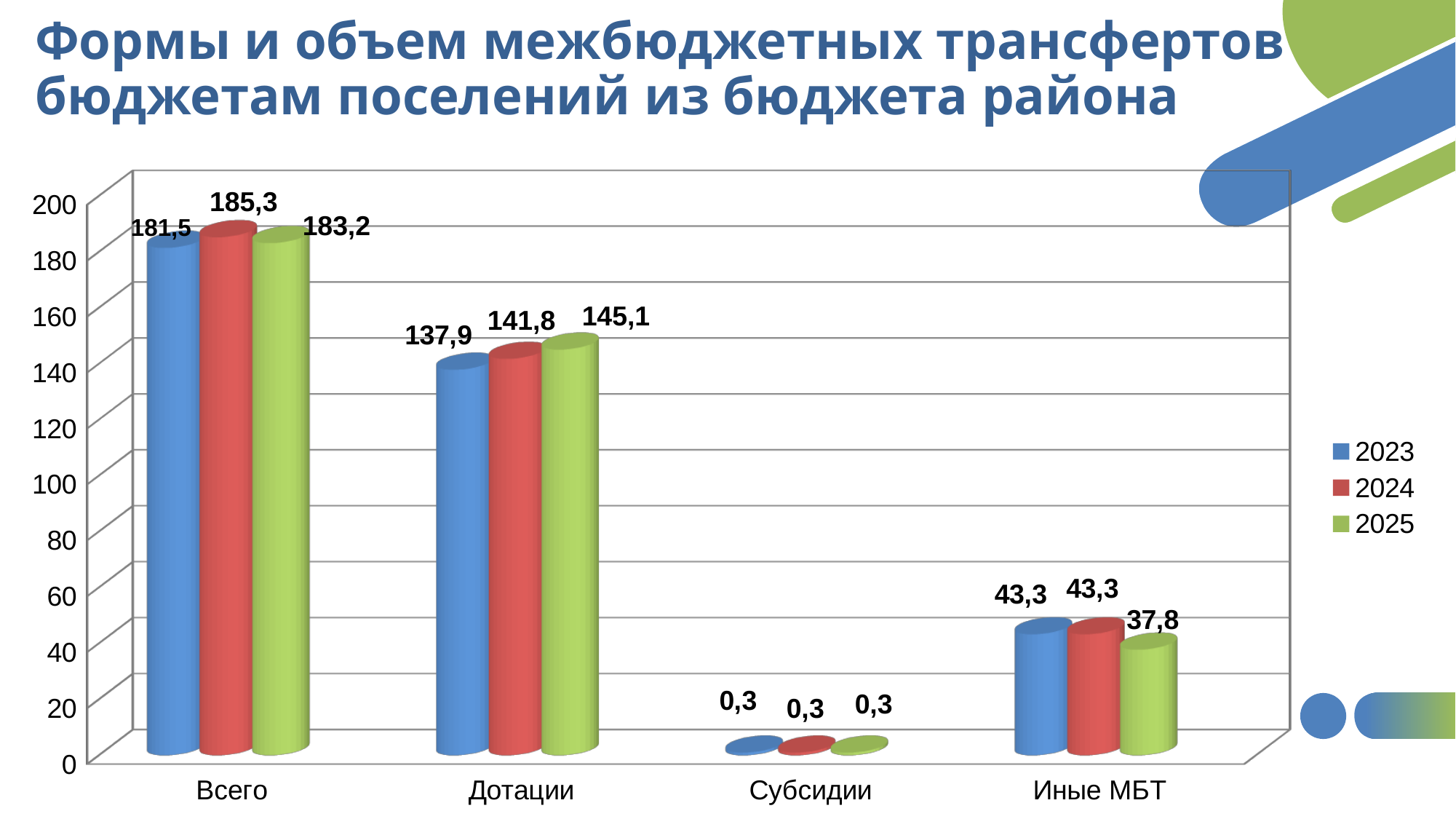
What is the value for Субсидии in 2024? 0,3 What is the value for Дотации in 2025? 145,1 What kind of chart is shown on the slide? Bar chart How many categories are shown on the x axis? 4 What is the value for Иные МБТ in 2023? 43,3 How many series does the legend list? 3 What is the difference between the 2025 and 2023 values for Дотации? 7,2 What is the difference between the 2024 and 2025 values for Иные МБТ? 5,5 Which year has the highest value for Всего? 2024 Which is larger: the 2023 value for Дотации or the 2024 value for Дотации? 2024 What is the value for Всего in 2024? 185,3 Which category has the lowest values across all years? Субсидии